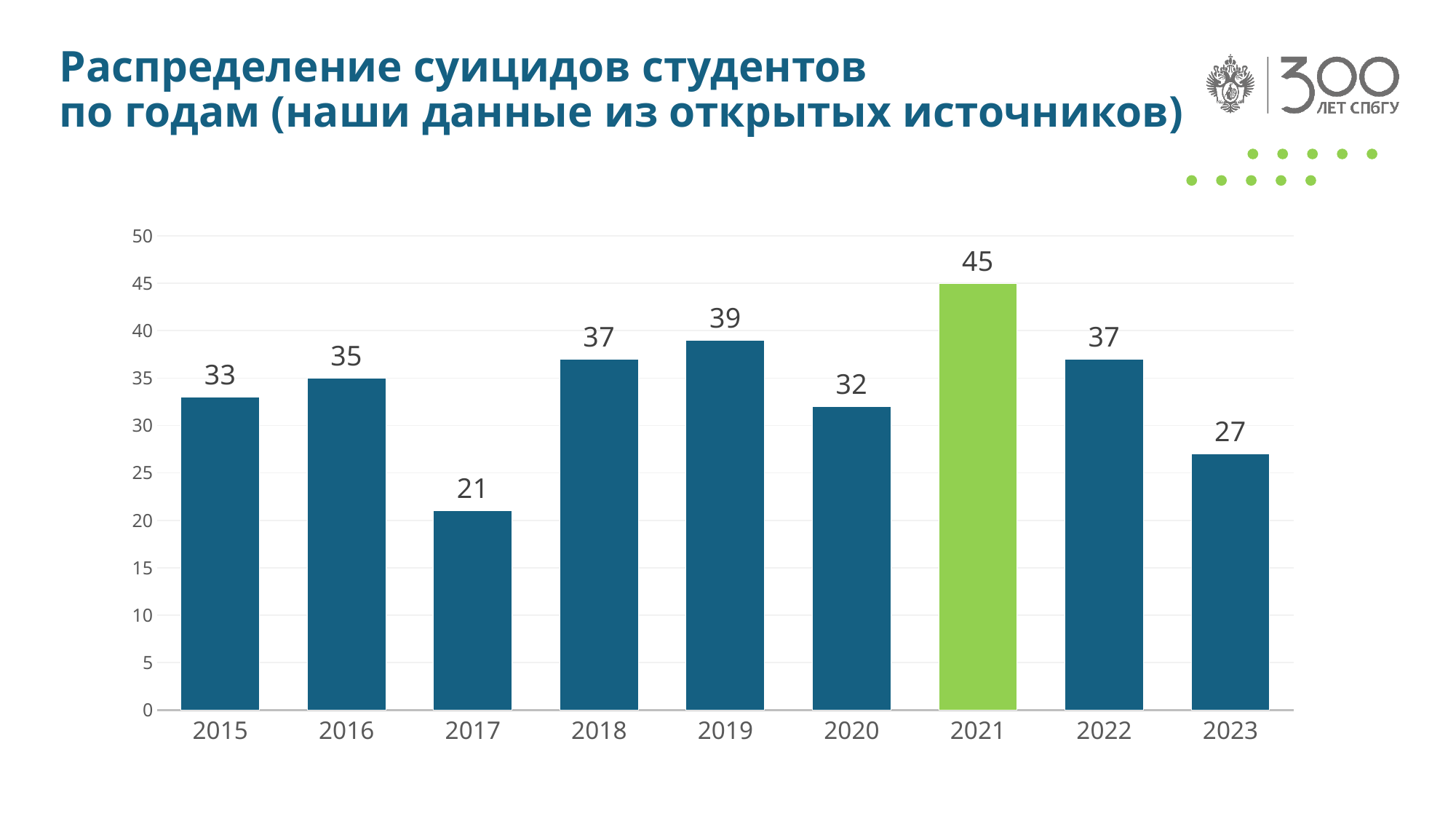
Which is larger, the value for 2016 or the value for 2022? 2022 Which year has the lowest value? 2017 What is the value for 2023? 27 Which bar is highlighted in green? 2021 What kind of chart is shown on the slide? bar chart What is the difference between the values for 2019 and 2020? 7 Is the value for 2023 greater or less than 30? less How many years are shown on the x axis? 9 What is the difference between the values for 2021 and 2017? 24 Which year has the highest value? 2021 What is the value for 2021? 45 What is the value for 2017? 21